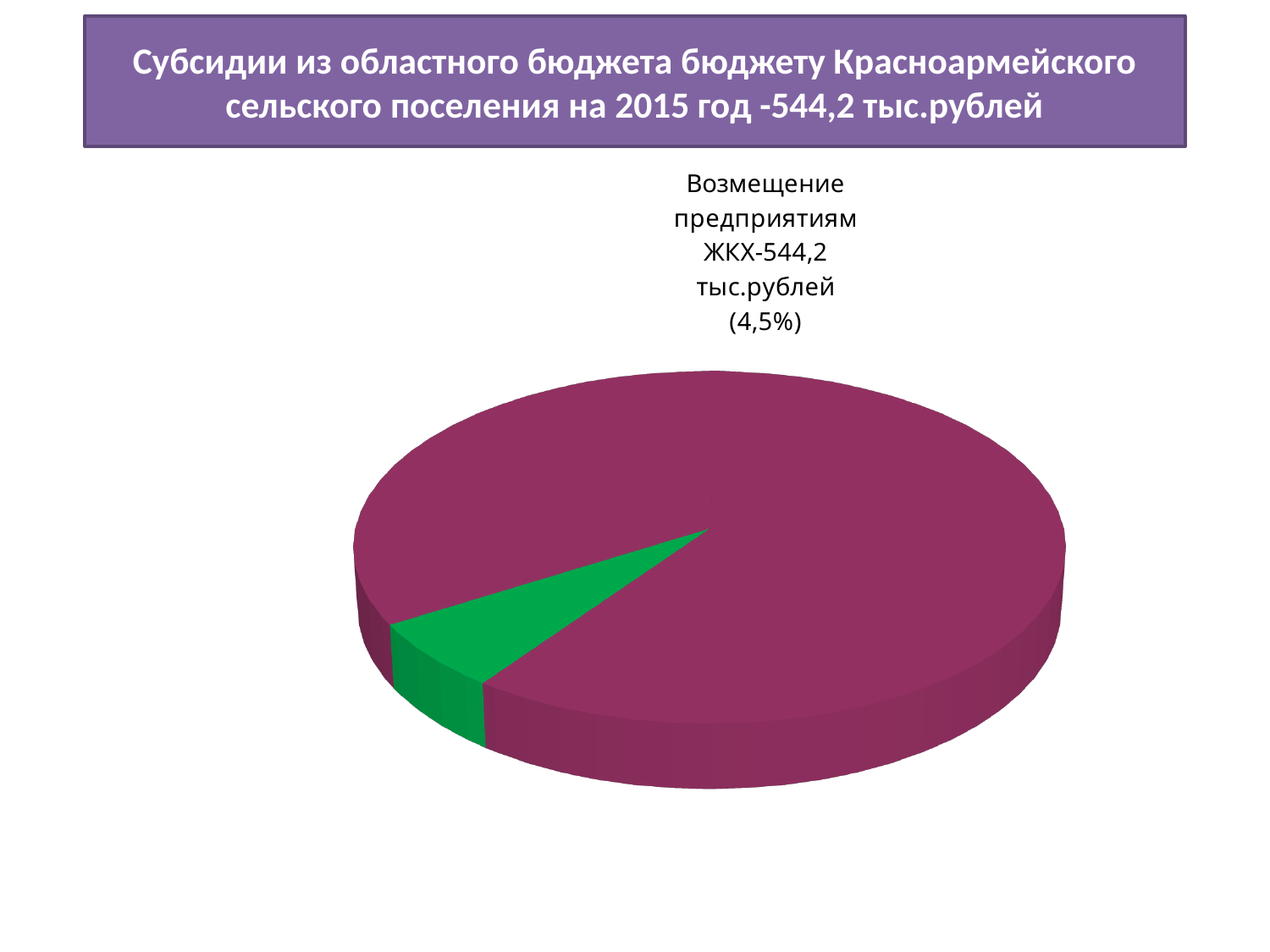
Which slice is larger, the green slice or the magenta slice? The magenta slice Is the share of the "Возмещение предприятиям ЖКХ" slice greater or less than 10%? less Which slice of the pie is the smallest? Возмещение предприятиям ЖКХ What share of the pie does the "Возмещение предприятиям ЖКХ" slice represent, as printed on the slide? 4,5% How many slices does the pie chart have? 2 What total amount of subsidies for 2015 is stated in the slide title? 544,2 тыс.рублей What value is shown for the slice labelled "Возмещение предприятиям ЖКХ"? 544,2 тыс.рублей What kind of chart is shown on the slide? Pie chart What colour is the slice labelled "Возмещение предприятиям ЖКХ"? Green